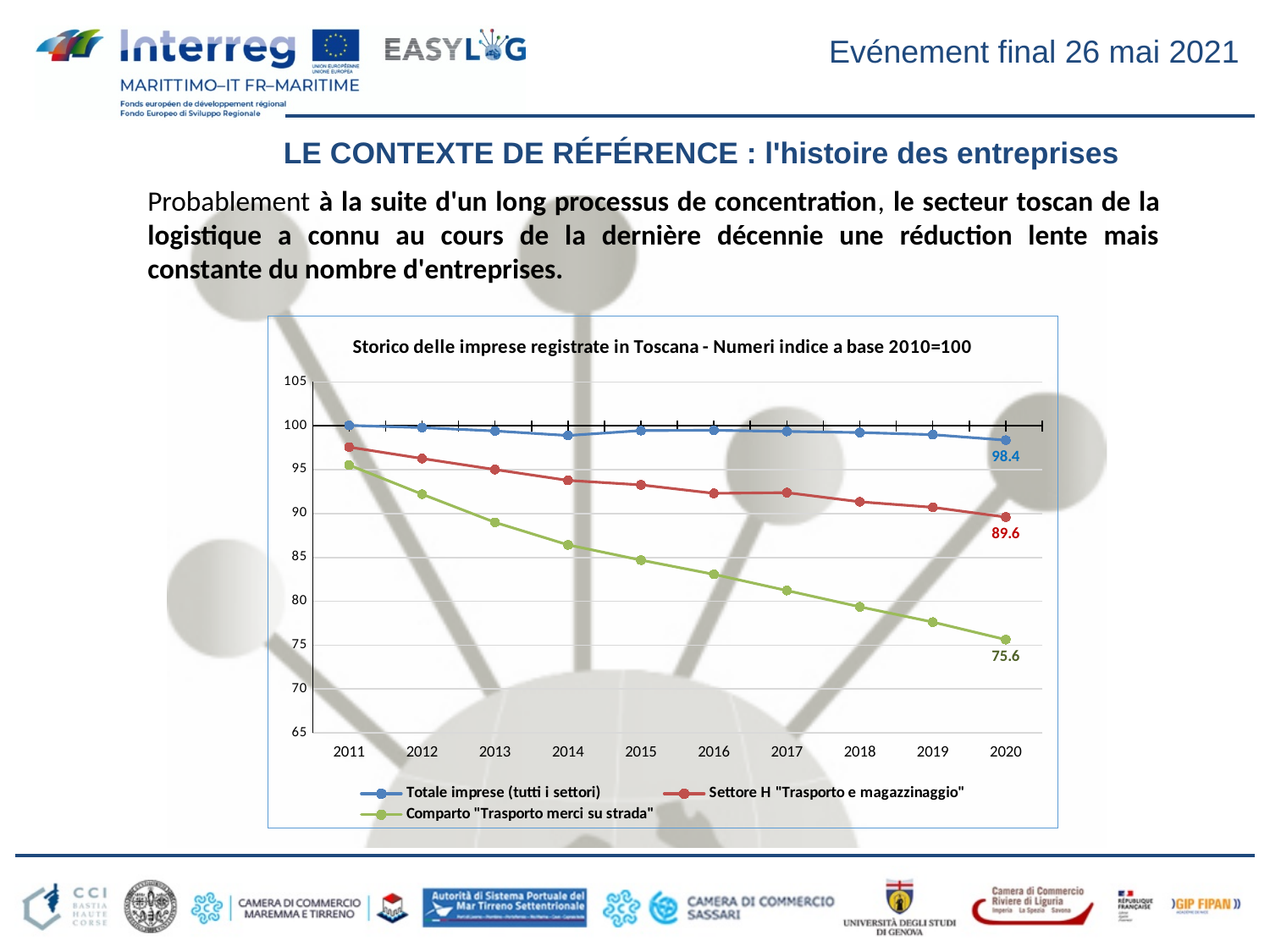
Is the 2011 value for Comparto "Trasporto merci su strada" greater or less than 90? greater How many years are shown on the x axis? 10 What is the 2020 value for Comparto "Trasporto merci su strada"? 75.6 What type of chart is shown on the slide? line chart What is the title of the chart? Storico delle imprese registrate in Toscana - Numeri indice a base 2010=100 Which series has the lowest value in 2020? Comparto "Trasporto merci su strada" How many series does the legend list? 3 Which series is larger in 2015, Settore H "Trasporto e magazzinaggio" or Comparto "Trasporto merci su strada"? Settore H "Trasporto e magazzinaggio" Does the Comparto "Trasporto merci su strada" series rise or fall from 2011 to 2020? fall What is the difference between the 2020 values of "Totale imprese (tutti i settori)" and Comparto "Trasporto merci su strada"? 22.8 What is the 2020 value for Settore H "Trasporto e magazzinaggio"? 89.6 What is the 2020 value for "Totale imprese (tutti i settori)"? 98.4